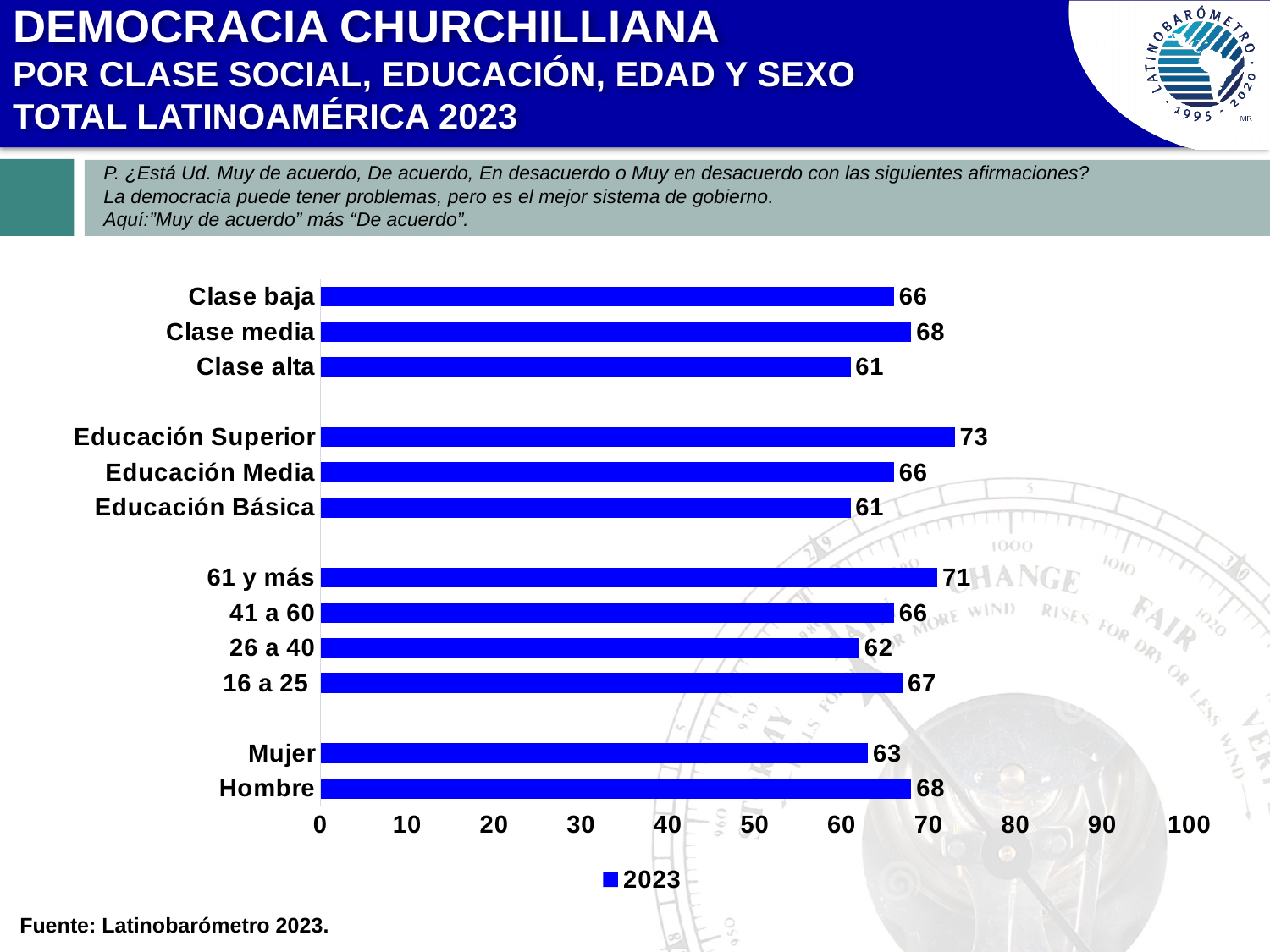
What kind of chart is shown on the slide? Bar chart Which of the three social class categories (Clase baja, Clase media, Clase alta) has the lowest value? Clase alta What is the difference between the values for Educación Superior and Educación Básica? 12 How many categories are plotted in the chart? 12 What is the value for Educación Superior? 73 How many series does the legend list? 1 Which category has the highest value? Educación Superior What is the difference between the values for Hombre and Mujer? 5 Which is larger, the value for 61 y más or the value for 16 a 25? 61 y más Is the value for Clase media greater or less than 60? greater What is the value for Mujer? 63 What is the value for 26 a 40? 62